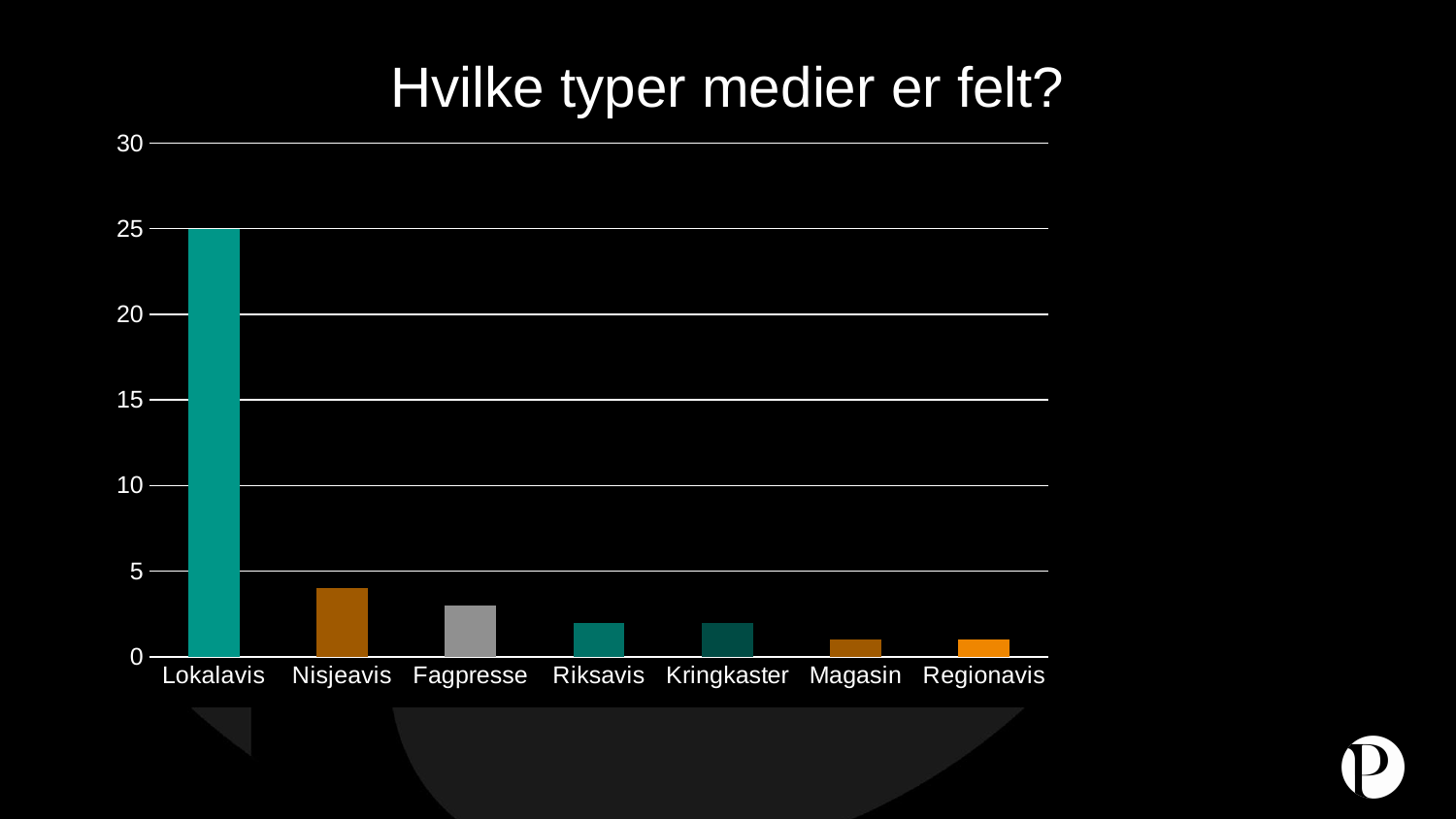
How many categories are shown on the x axis? 7 Do the values generally rise or fall from left to right along the x axis? fall What is the value for Lokalavis? 25 Is the value for Fagpresse greater or less than 5? less What is the highest value shown on the y axis? 30 Is the value for Lokalavis greater or less than 20? greater Which category has the highest value? Lokalavis Which is larger, the value for Nisjeavis or the value for Fagpresse? Nisjeavis Which is larger, the value for Lokalavis or the value for Nisjeavis? Lokalavis What is the title of the chart? Hvilke typer medier er felt? What kind of chart is shown on the slide? bar chart Is the value for Nisjeavis greater or less than 5? less